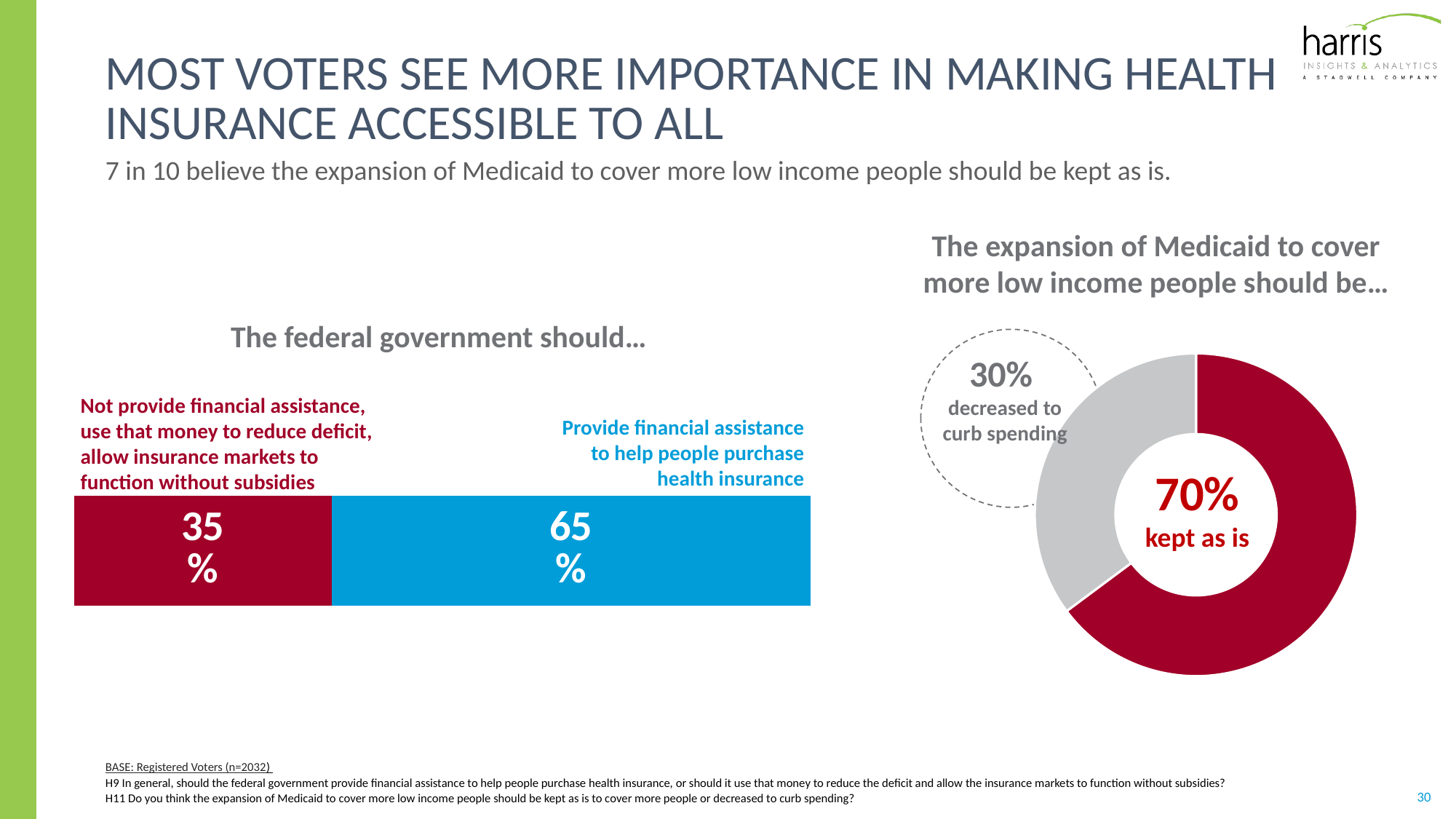
In the 'The federal government should…' chart, which option has the larger share: providing financial assistance or not providing financial assistance? Provide financial assistance to help people purchase health insurance In the 'The expansion of Medicaid to cover more low income people should be…' chart, what colour is the 'kept as is' slice? Red In the 'The expansion of Medicaid to cover more low income people should be…' chart, what is the difference in percentage points between 'kept as is' and 'decreased to curb spending'? 40 In the 'The expansion of Medicaid to cover more low income people should be…' chart, which response has the largest share? Kept as is In the 'The federal government should…' chart, what is the difference in percentage points between the two options? 30 In the 'The federal government should…' chart, what percentage of voters say the government should not provide financial assistance and use that money to reduce the deficit? 35% In the 'The expansion of Medicaid to cover more low income people should be…' chart, what percentage say it should be kept as is? 70% What kind of chart is 'The federal government should…'? Bar chart In the 'The federal government should…' chart, what is the total of the two segments of the bar? 100% In the 'The federal government should…' chart, what percentage of voters say the government should provide financial assistance to help people purchase health insurance? 65% What kind of chart is 'The expansion of Medicaid to cover more low income people should be…'? Pie chart (donut) In the 'The expansion of Medicaid to cover more low income people should be…' chart, what percentage say it should be decreased to curb spending? 30%